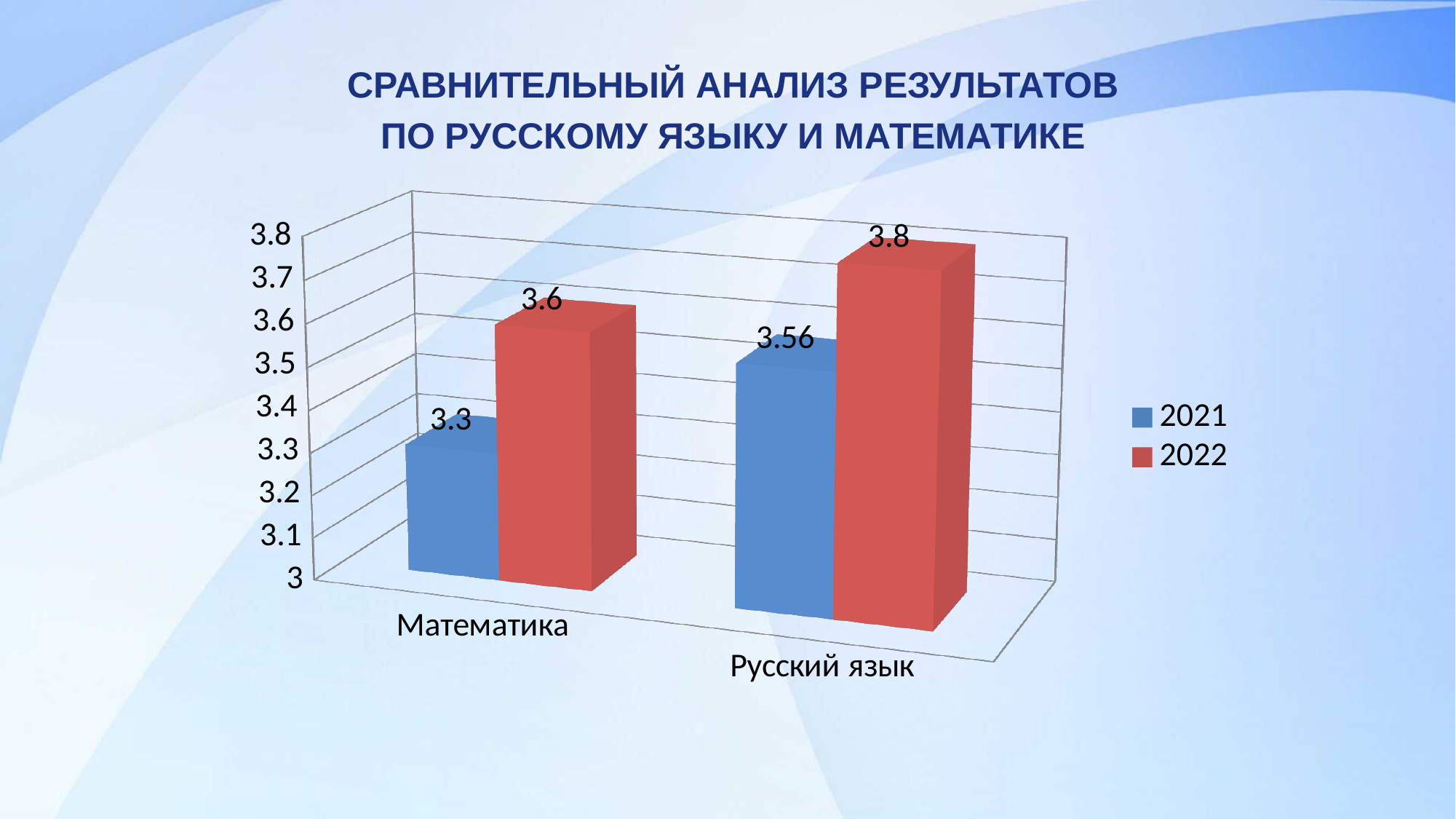
What is the value for Математика in 2022? 3.6 Which is larger: the 2021 value for Русский язык or the 2022 value for Математика? 2022 value for Математика What is the difference between the 2022 and 2021 values for Математика? 0.3 What is the value for Математика in 2021? 3.3 How many series does the legend list? 2 What is the value for Русский язык in 2022? 3.8 Which category has the lowest value in 2021? Математика Which category has the highest value in 2022? Русский язык What is the value for Русский язык in 2021? 3.56 How many categories are shown on the x axis? 2 What is the difference between the 2022 and 2021 values for Русский язык? 0.24 What kind of chart is shown on the slide? Bar chart